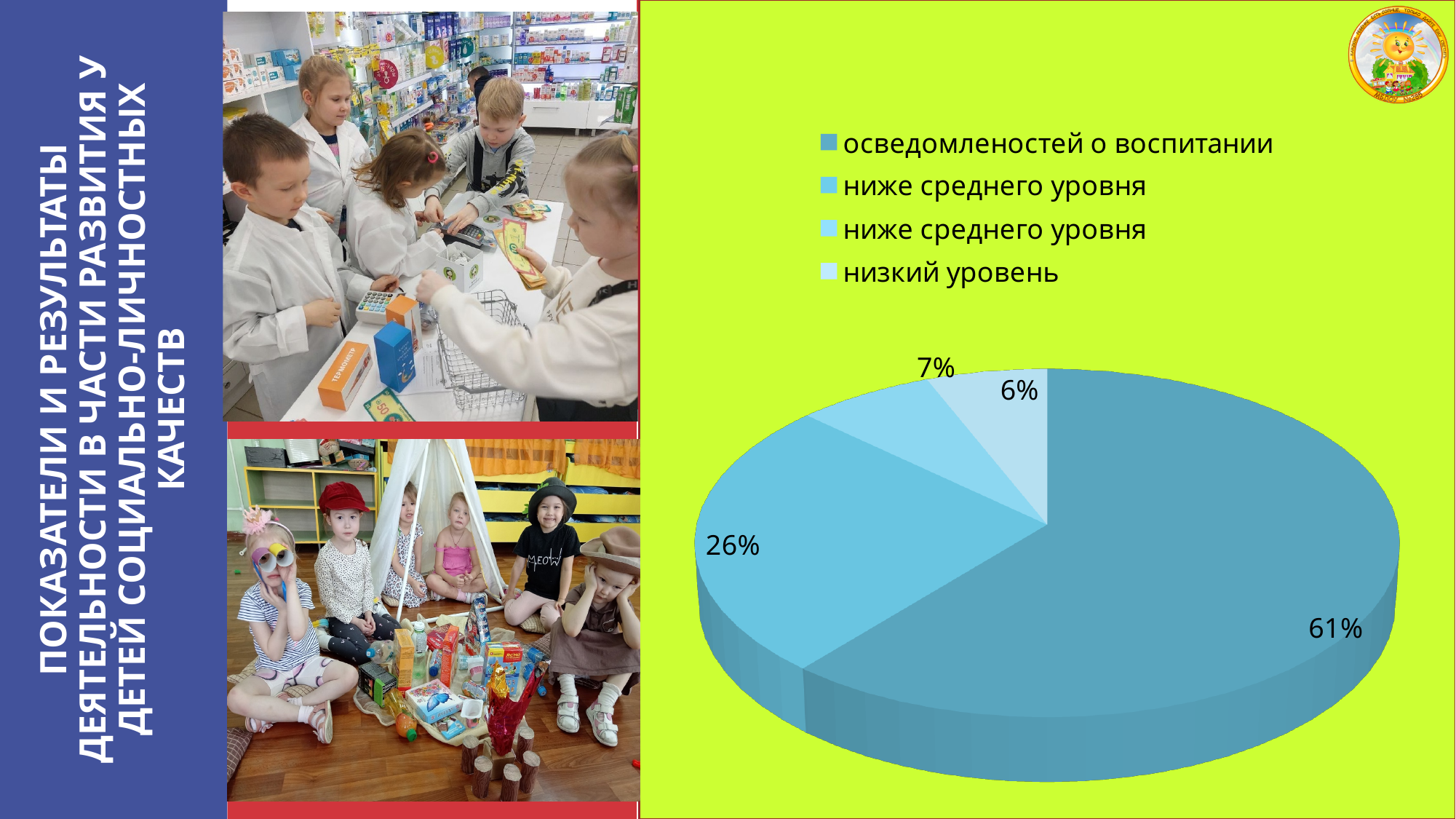
How many slices does the pie chart have? 4 Which category is listed first in the pie chart's legend? осведомленостей о воспитании Which legend category has the largest slice of the pie? осведомленостей о воспитании What percentage is shown for the slice "низкий уровень"? 6% How many entries does the legend of the pie chart list? 4 Which legend label appears twice in the pie chart's legend? ниже среднего уровня What percentage is shown for the slice "осведомленостей о воспитании"? 61% What is the difference in percentage points between the "осведомленостей о воспитании" slice and the "низкий уровень" slice? 55 Which slice is larger: "осведомленостей о воспитании" or "низкий уровень"? осведомленостей о воспитании What share of the pie does the largest slice take? 61% Which legend category has the smallest slice of the pie? низкий уровень What kind of chart is shown on the slide? pie chart